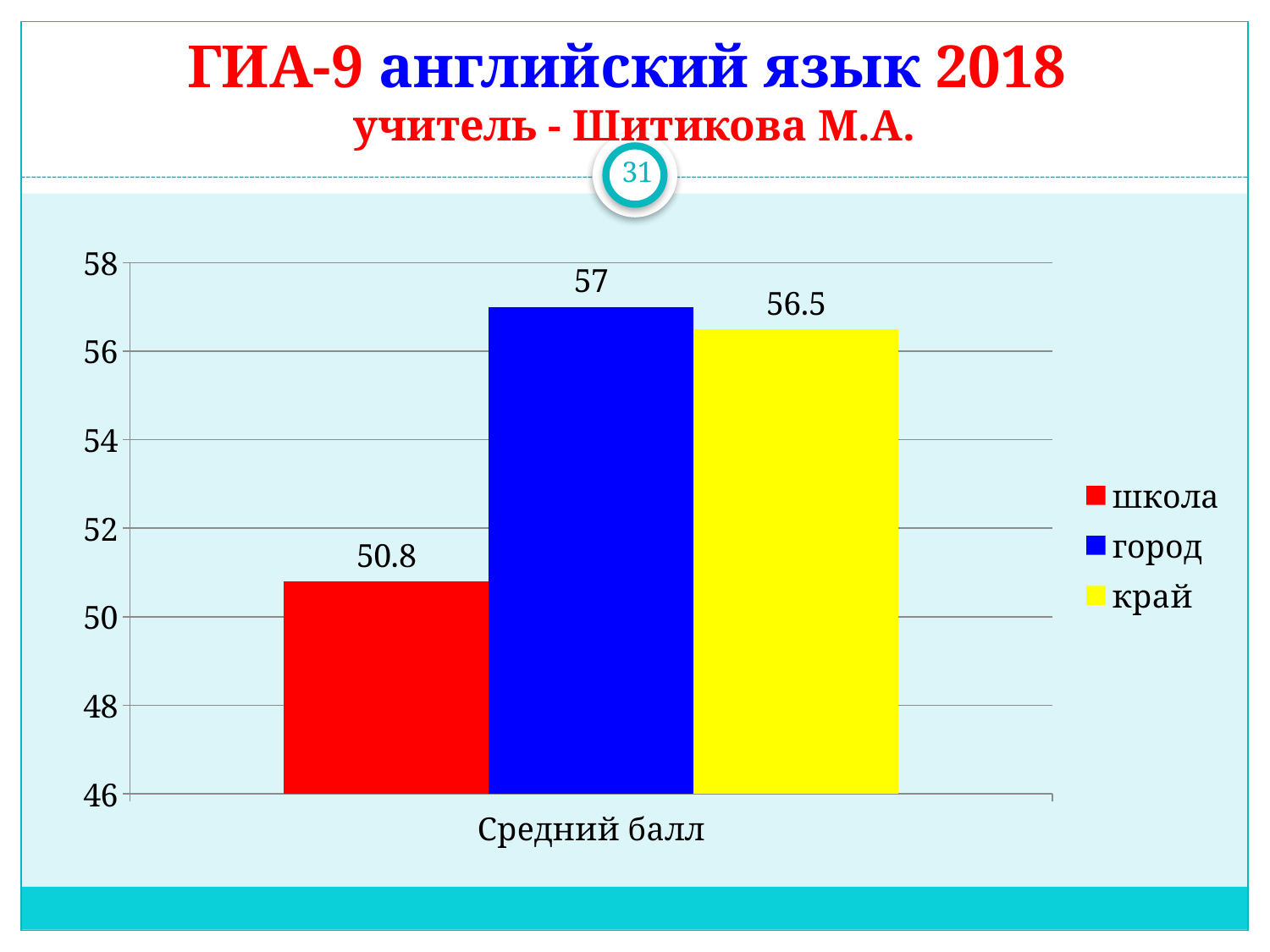
What is the value for край (region) in the Средний балл chart? 56.5 What kind of chart is shown on the slide? bar chart Which series has the highest average score? город What colour is the bar for город? blue What is the value for школа (school) in the Средний балл chart? 50.8 Which is larger, the value for край or the value for школа? край Is the value for школа greater or less than 52? less How many series does the legend list? 3 What is the value for город (city) in the Средний балл chart? 57 What is the difference between the город value and the край value? 0.5 What is the difference between the город value and the школа value? 6.2 Which series has the lowest average score? школа